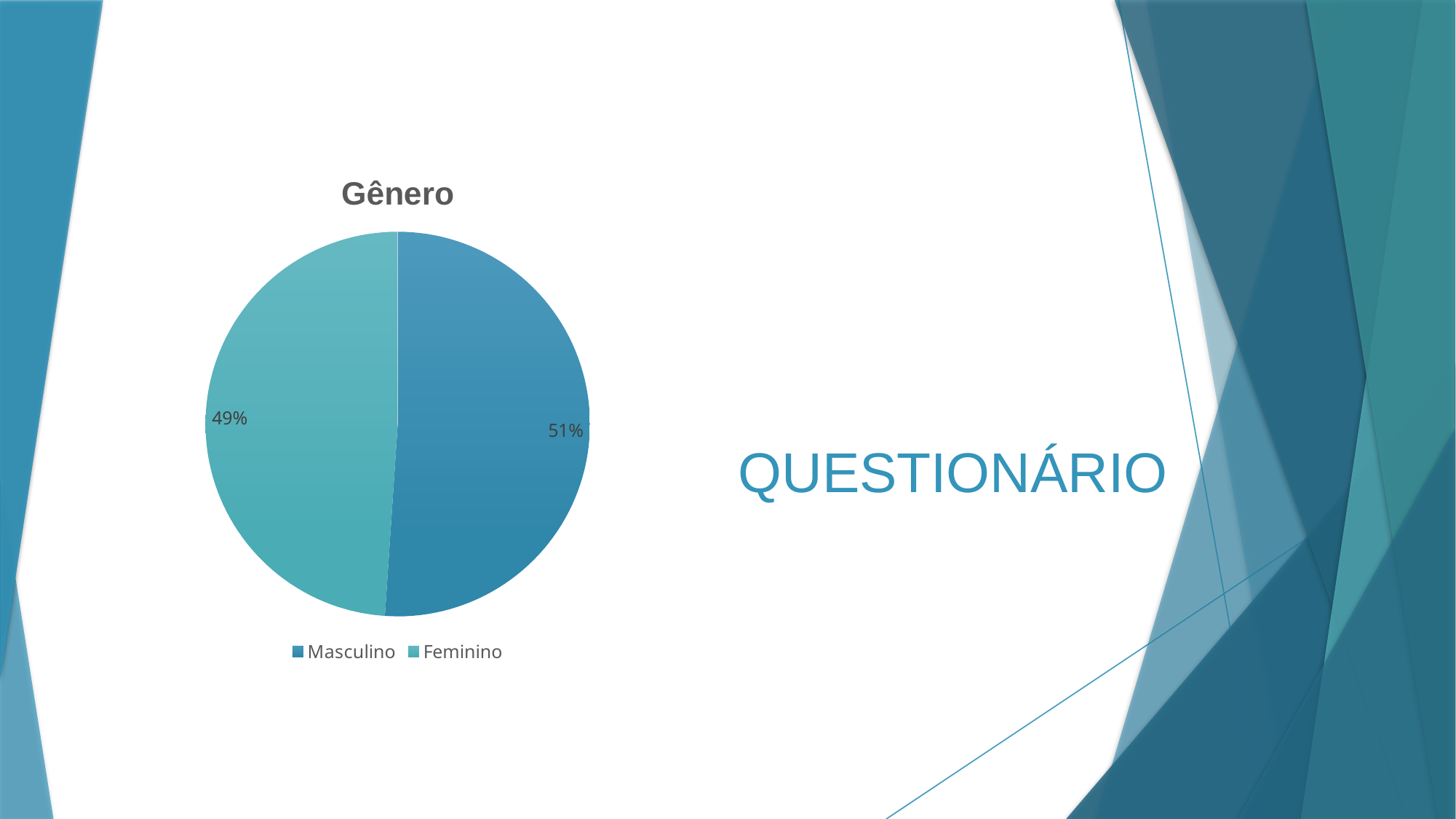
What share of the pie does Masculino represent? 51% How many categories does the pie chart show? 2 What is the difference in percentage points between the Masculino and Feminino slices? 2% How many entries does the legend list? 2 Which category has the smallest slice of the pie? Feminino Is the value for Masculino greater or less than 50%? greater Which is larger, the Masculino slice or the Feminino slice? Masculino What share of the pie does Feminino represent? 49% Which legend entry is shown in the lighter teal colour? Feminino Which category has the largest slice of the pie? Masculino What is the title of the chart? Gênero What kind of chart is shown on the slide? pie chart